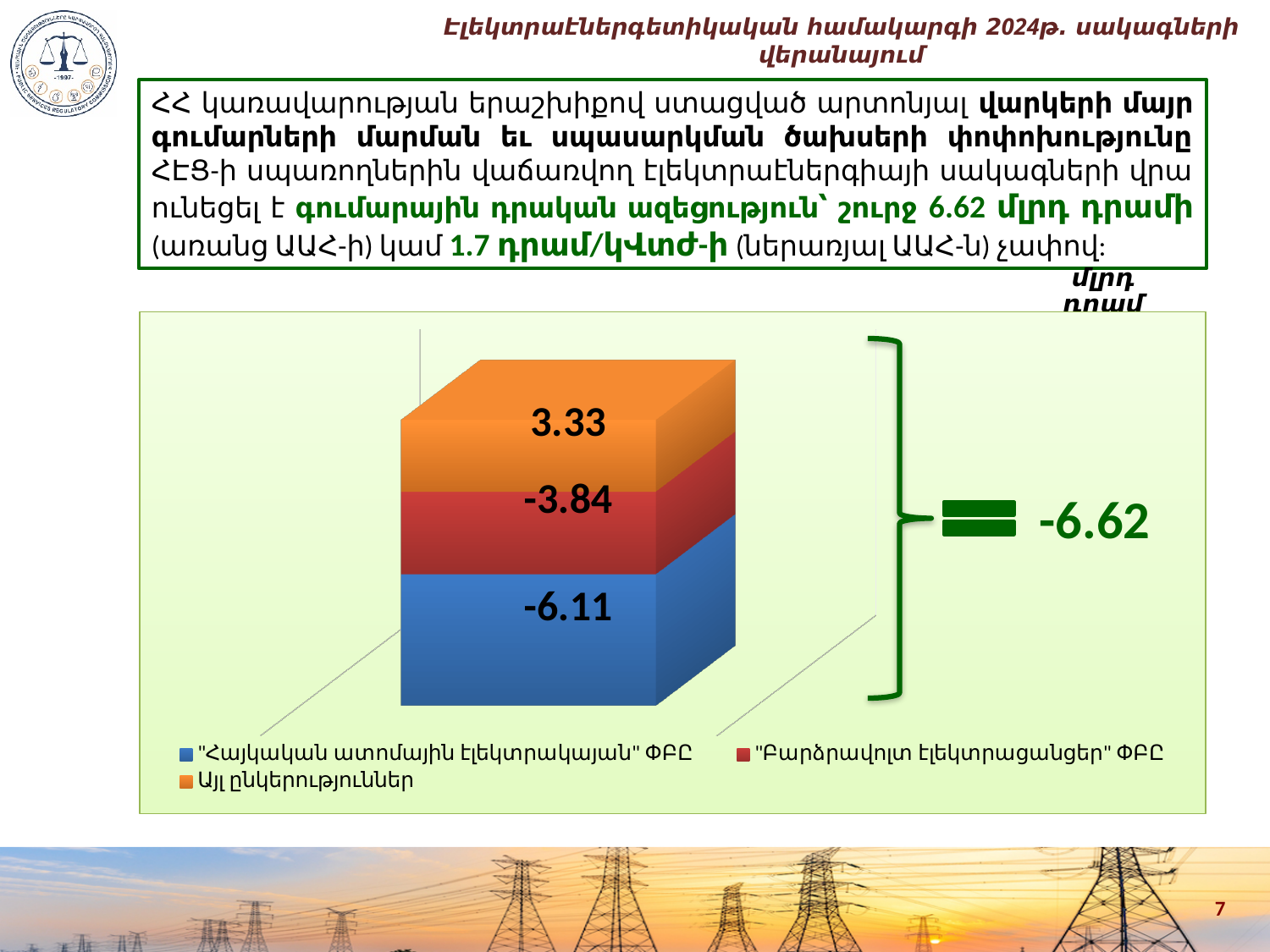
What total is shown next to the bracket to the right of the stacked bar? -6.62 Which series has the lowest (most negative) value in the stacked bar? "Հայկական ատոմային էլեկտրակայան" ՓԲԸ What is the value of the blue segment labelled "Հայկական ատոմային էլեկտրակայան" ՓԲԸ in the stacked bar? -6.11 What kind of chart is shown on the slide? Stacked bar chart What is the difference between the values for "Հայկական ատոմային էլեկտրակայան" ՓԲԸ and "Բարձրավոլտ էլեկտրացանցեր" ՓԲԸ? 2.27 Which colour represents Այլ ընկերություններ in the chart? Orange Which series has the highest value in the stacked bar? Այլ ընկերություններ Which is larger, the value for "Բարձրավոլտ էլեկտրացանցեր" ՓԲԸ or the value for Այլ ընկերություններ? Այլ ընկերություններ How many series does the chart legend list? 3 What is the value of the red segment labelled "Բարձրավոլտ էլեկտրացանցեր" ՓԲԸ in the stacked bar? -3.84 What is the value of the orange segment labelled Այլ ընկերություններ in the stacked bar? 3.33 What unit is indicated above the chart? մլրդ դրամ